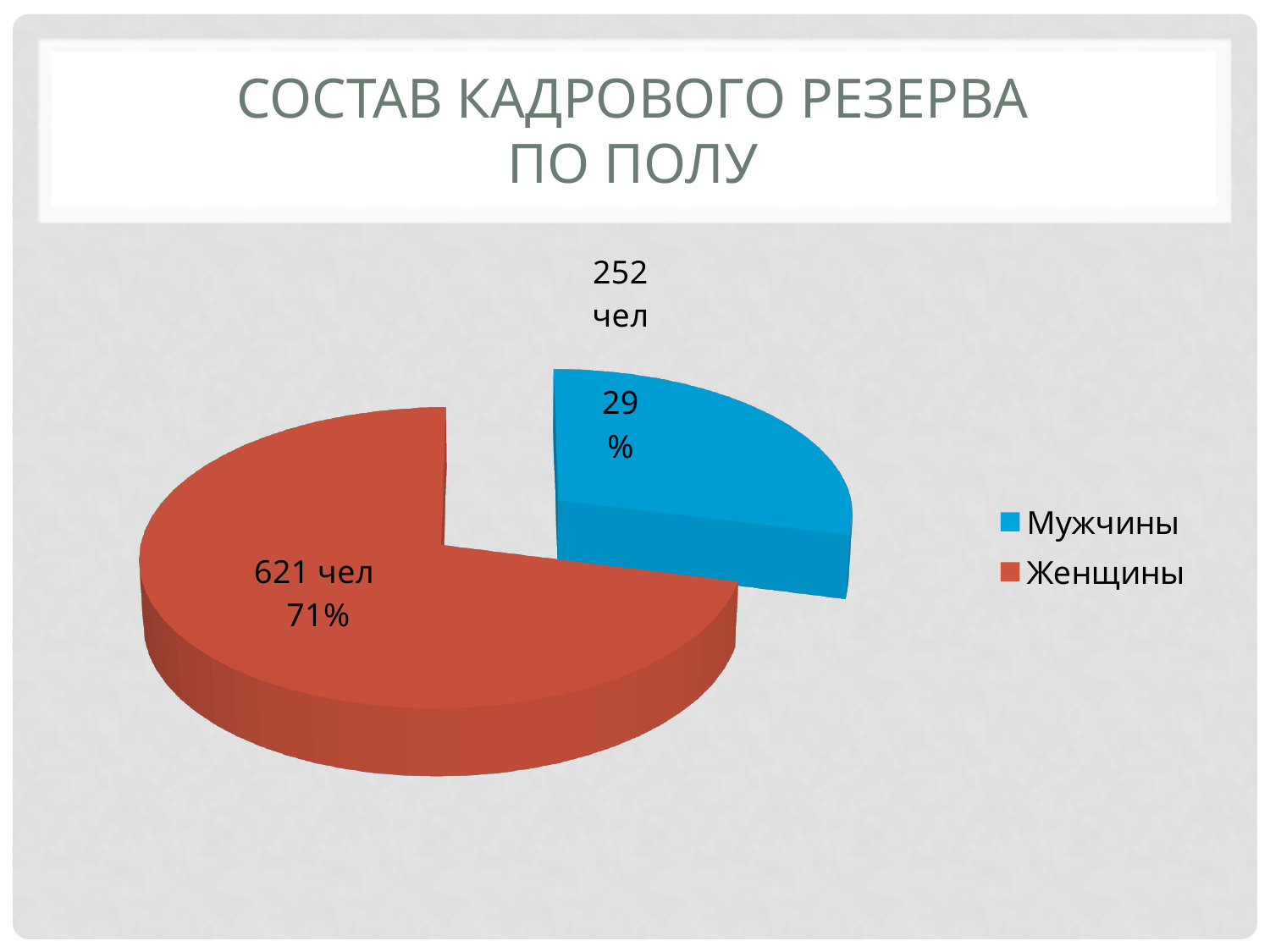
What share of the pie does the Мужчины slice represent? 29% What colour is the Мужчины slice? blue What share of the pie does the Женщины slice represent? 71% How many people are in the Мужчины category? 252 чел Which category has the smallest slice? Мужчины How many people are in the Женщины category? 621 чел Which category has the largest slice? Женщины What is the total number of people across both slices? 873 чел How many categories does the pie chart have? 2 Which is larger, the Мужчины slice or the Женщины slice? Женщины What kind of chart is shown on the slide? pie chart What is the difference in number of people between Женщины and Мужчины? 369 чел